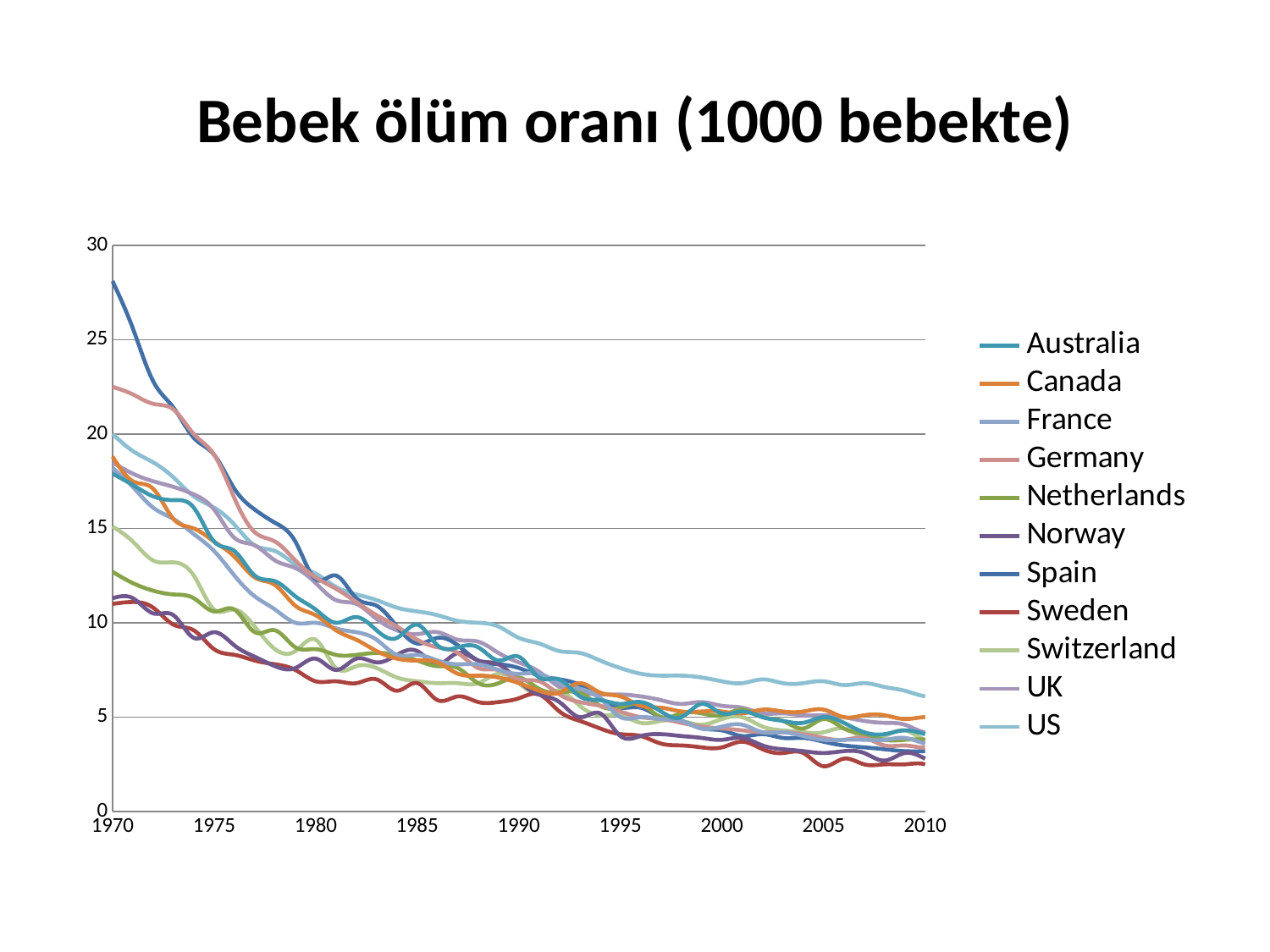
Is the value for Germany in 1970 greater or less than 20? greater Is the value for Spain in 1970 greater or less than 25? greater Which country has the highest value in 2010? US What kind of chart is shown on the slide? line chart Which country has the highest value in 1970? Spain Is the value for the US in 2010 greater or less than 10? less How many series does the legend list? 11 In 2010, which is larger: the value for the US or the value for Sweden? US What is the title of the chart? Bebek ölüm oranı (1000 bebekte) Do the values generally rise or fall from 1970 to 2010? fall In 1970, which is larger: the value for Spain or the value for Sweden? Spain